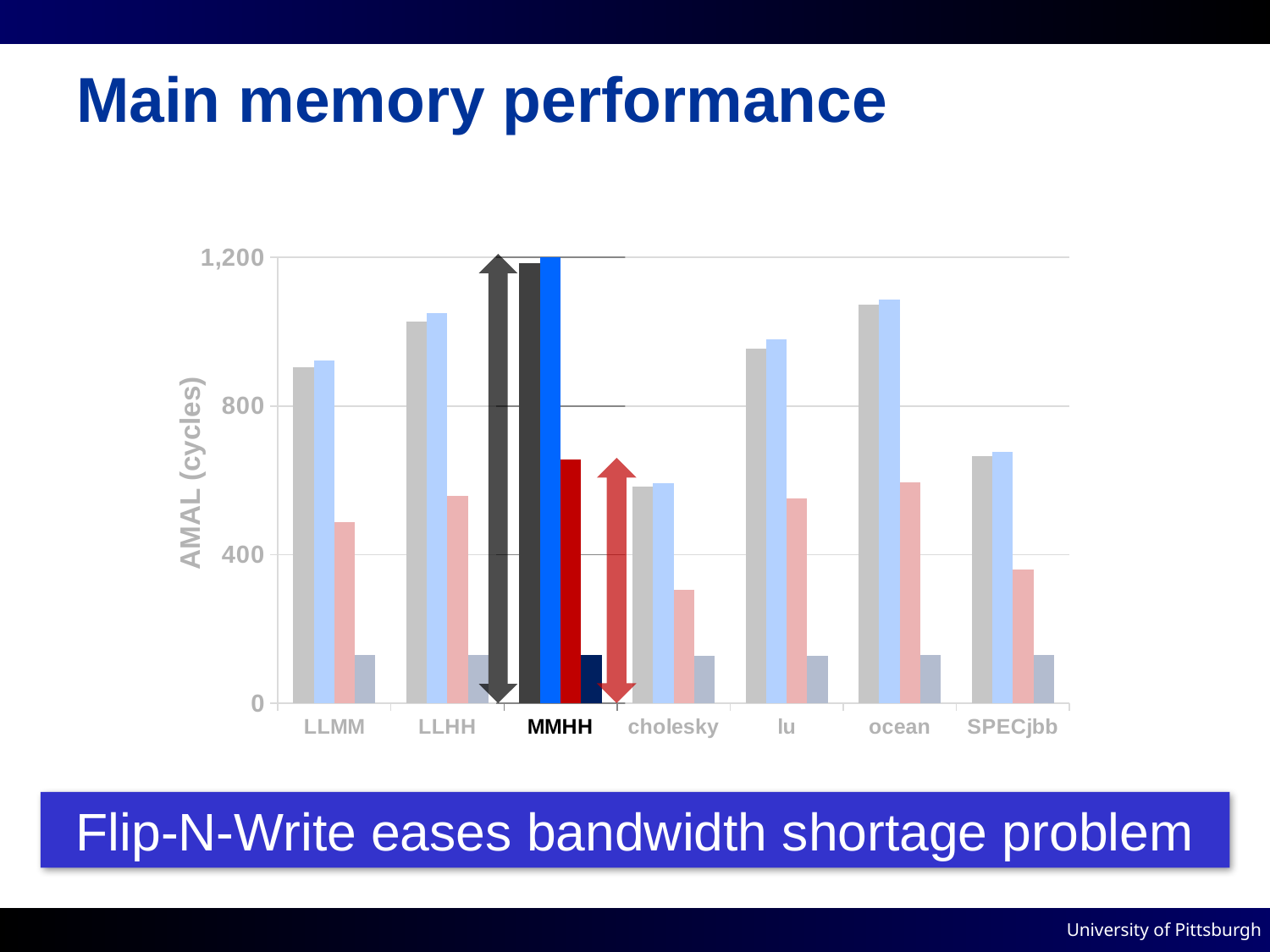
What is the label of the y axis of the chart? AMAL (cycles) Is the value of the fourth (rightmost) bar for LLMM greater or less than 400? less Which is larger: the first (leftmost) bar for MMHH or the first (leftmost) bar for cholesky? MMHH Is the value of the first (leftmost) bar for MMHH greater or less than 800? greater What kind of chart is shown on the slide? bar chart Which category contains the tallest bar in the chart? MMHH Is the value of the third bar for cholesky greater or less than 400? less How many categories are shown on the x axis of the chart? 7 Which category has the lowest value for the first (leftmost) bar? cholesky How many bars are plotted for each category in the chart? 4 Which category label on the x axis is highlighted in bold black rather than grey? MMHH